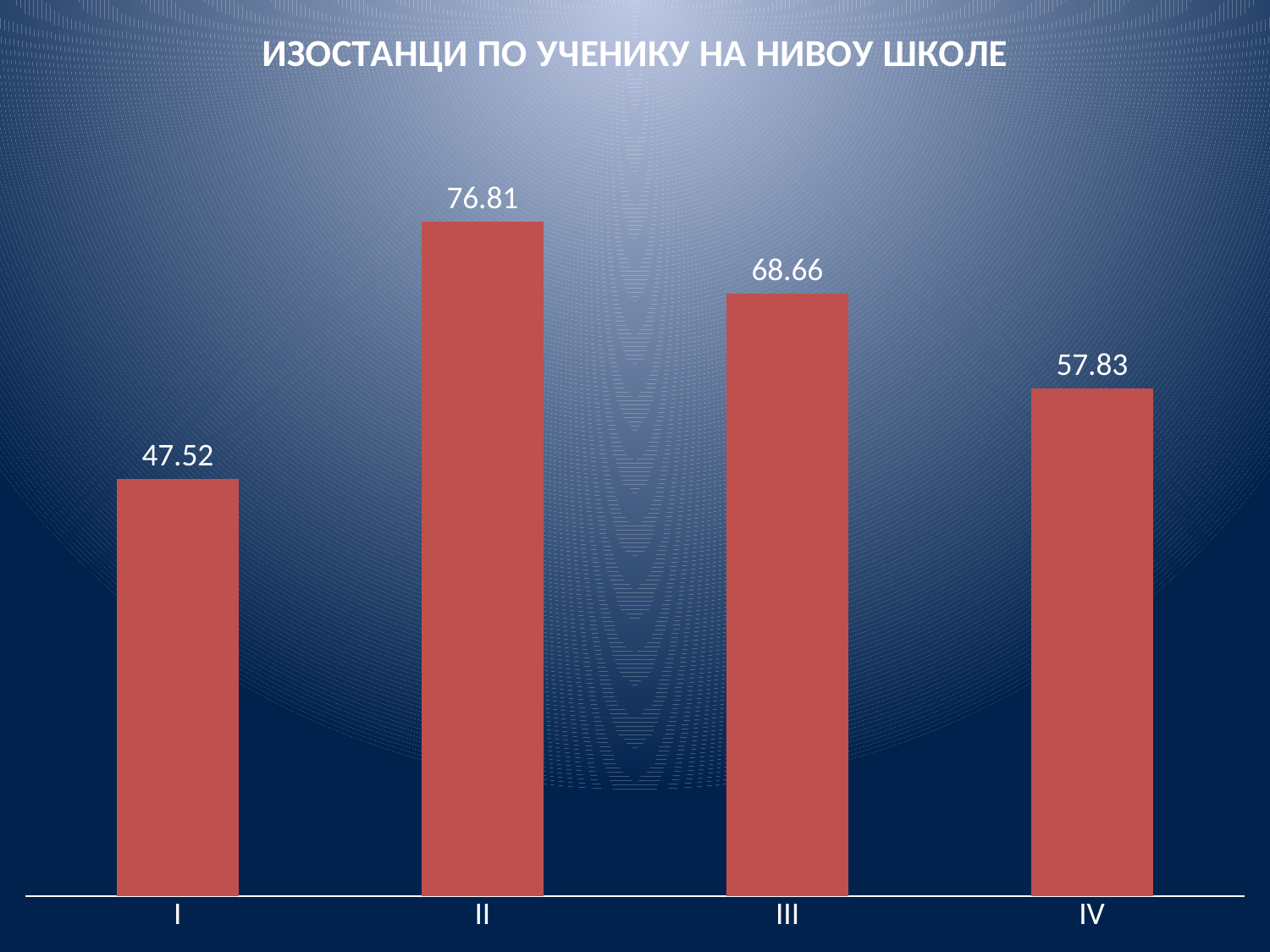
What is the title of the chart? ИЗОСТАНЦИ ПО УЧЕНИКУ НА НИВОУ ШКОЛЕ What is the value for category I? 47.52 Do the values rise or fall from category II to category IV? fall What is the value for category IV? 57.83 What is the difference between the values for IV and I? 10.31 What is the difference between the values for II and III? 8.15 Which category has the highest value? II Which category has the lowest value? I Which is larger, the value for III or the value for IV? III How many categories are shown on the x axis? 4 What is the value for category II? 76.81 What kind of chart is this? bar chart